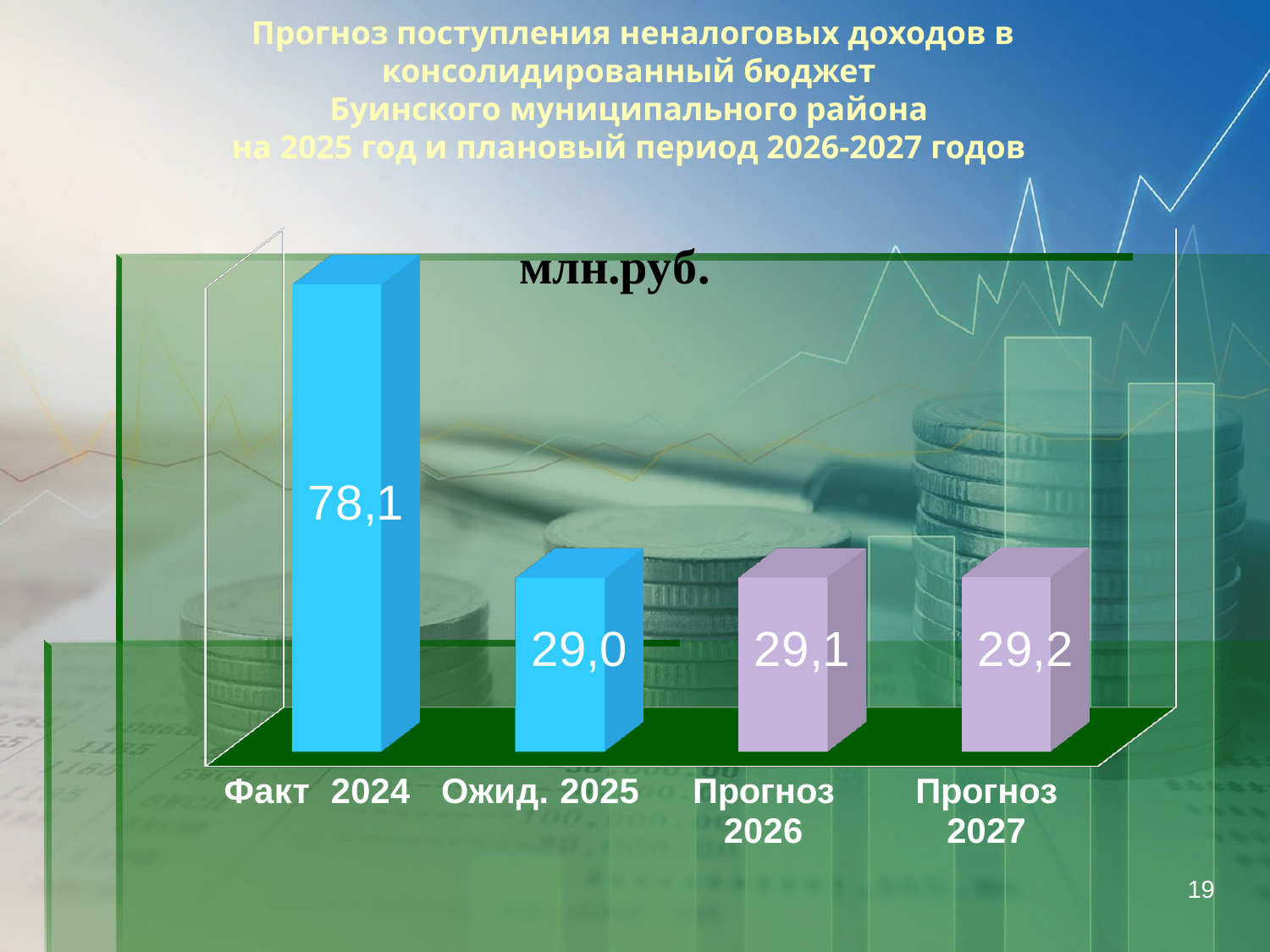
What is the value for Ожид. 2025? 29,0 What is the difference between the values for Факт 2024 and Ожид. 2025? 49,1 Which category has the lowest value? Ожид. 2025 How many categories are shown on the chart? 4 What is the difference between the values for Прогноз 2027 and Прогноз 2026? 0,1 Which category has the highest value? Факт 2024 What is the value for Факт 2024? 78,1 Which is larger, the value for Факт 2024 or the value for Прогноз 2027? Факт 2024 What kind of chart is shown on the slide? bar chart In what units are the values on the chart expressed? млн.руб. What is the value for Прогноз 2026? 29,1 What is the value for Прогноз 2027? 29,2